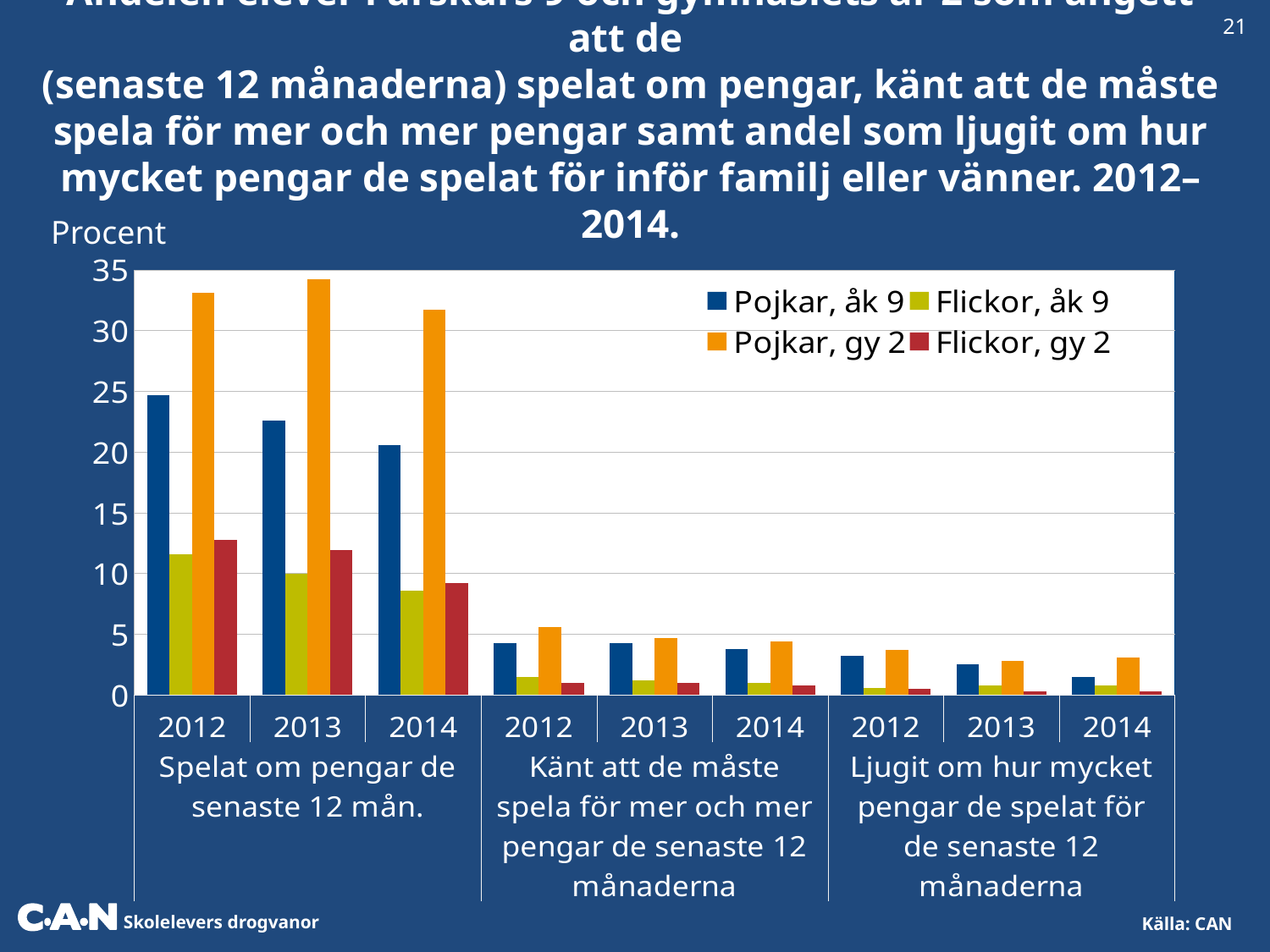
Do the values for Pojkar, åk 9 under 'Spelat om pengar de senaste 12 mån.' rise or fall from 2012 to 2014? fall How many year groups are shown along the x axis in total? 9 How many series does the legend list? 4 In 2012 under 'Spelat om pengar de senaste 12 mån.', which is larger: Flickor, åk 9 or Flickor, gy 2? Flickor, gy 2 Is the value for Pojkar, gy 2 in 2012 under 'Spelat om pengar de senaste 12 mån.' greater or less than 30? greater What kind of chart is shown on the slide? bar chart Is the value for Pojkar, åk 9 in 2014 under 'Spelat om pengar de senaste 12 mån.' greater or less than 25? less What label is shown above the y axis? Procent In 2014 under 'Ljugit om hur mycket pengar de spelat för de senaste 12 månaderna', which is larger: Pojkar, åk 9 or Pojkar, gy 2? Pojkar, gy 2 Is the value for Pojkar, åk 9 in 2012 under 'Spelat om pengar de senaste 12 mån.' greater or less than 20? greater Which series has the highest value in 2013 under 'Spelat om pengar de senaste 12 mån.'? Pojkar, gy 2 Which series has the lowest value in 2014 under 'Spelat om pengar de senaste 12 mån.'? Flickor, åk 9